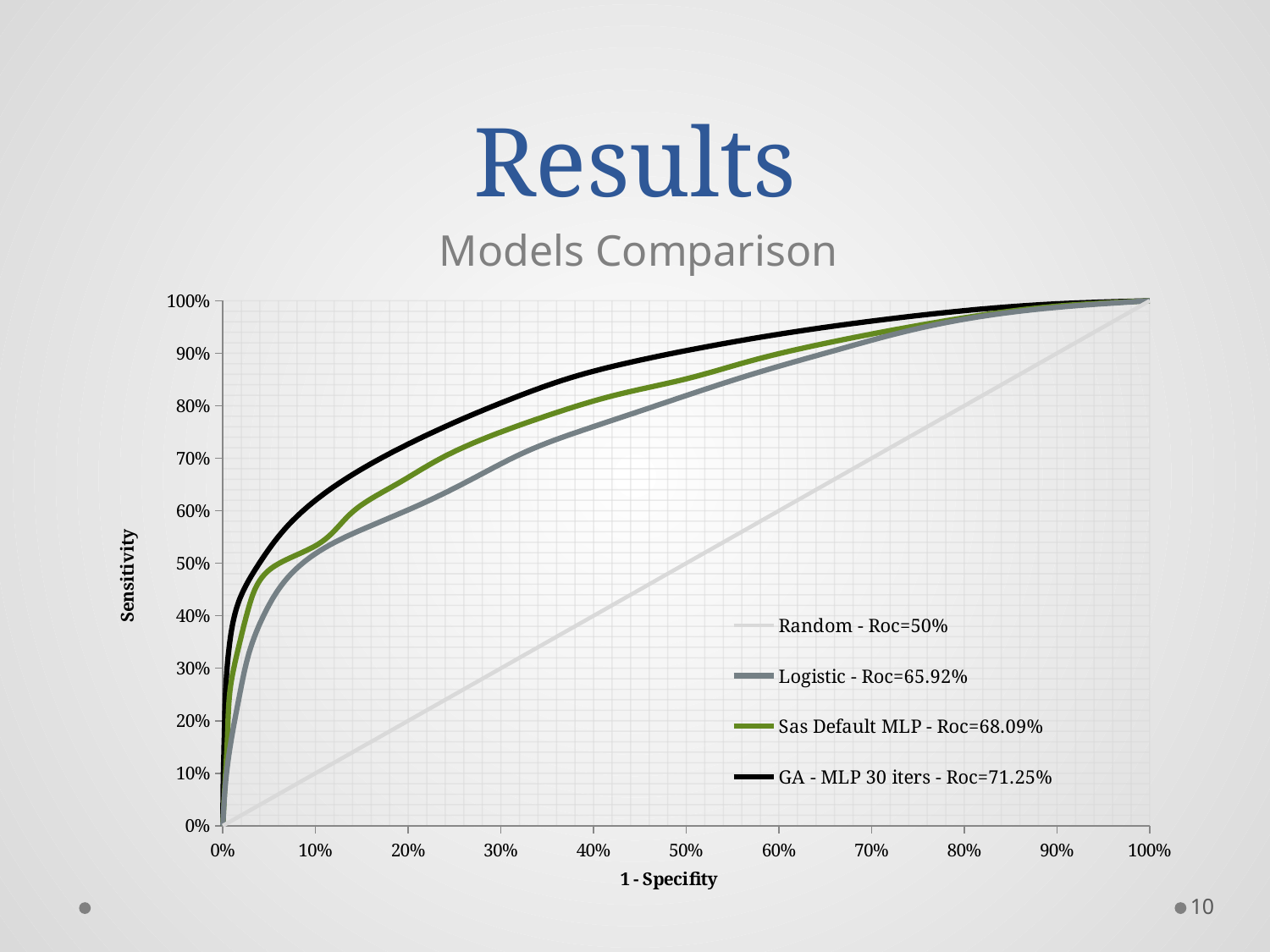
Which legend entry has the lowest ROC value? Random What kind of chart is shown on the slide? line chart What is the title of the chart? Models Comparison What ROC value is given in the legend for the GA - MLP 30 iters model? 71.25% What ROC value is given in the legend for the Logistic model? 65.92% What ROC value is given in the legend for the Sas Default MLP model? 68.09% Which model has the highest ROC value in the legend? GA - MLP 30 iters How many series does the legend list? 4 What is the difference between the ROC values of GA - MLP 30 iters and Logistic? 5.33% What is the label of the x axis? 1 - Specifity